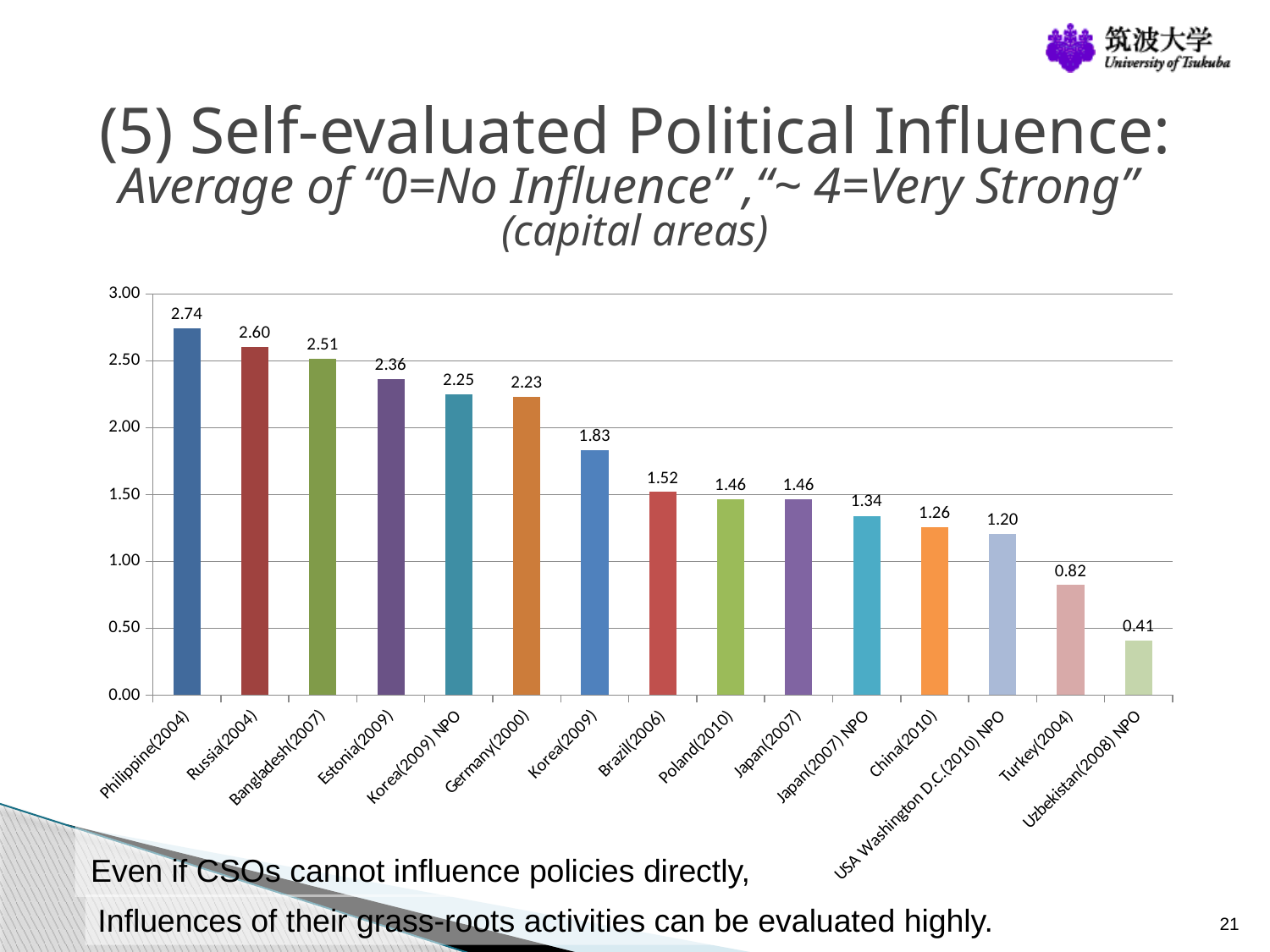
How many categories are shown on the x axis? 15 What is the difference between the values for Russia(2004) and Brazil(2006)? 1.08 What is the value for Germany(2000)? 2.23 Which category has the lowest value? Uzbekistan(2008) NPO What kind of chart is shown on the slide? Bar chart Which is larger, the value for Korea(2009) NPO or the value for Korea(2009)? Korea(2009) NPO What is the value for Japan(2007) NPO? 1.34 Is the value for China(2010) greater or less than 1.50? less What is the value for Philippine(2004)? 2.74 Do the values rise or fall from left to right along the x axis? Fall What is the value for Turkey(2004)? 0.82 Which category has the highest value? Philippine(2004)